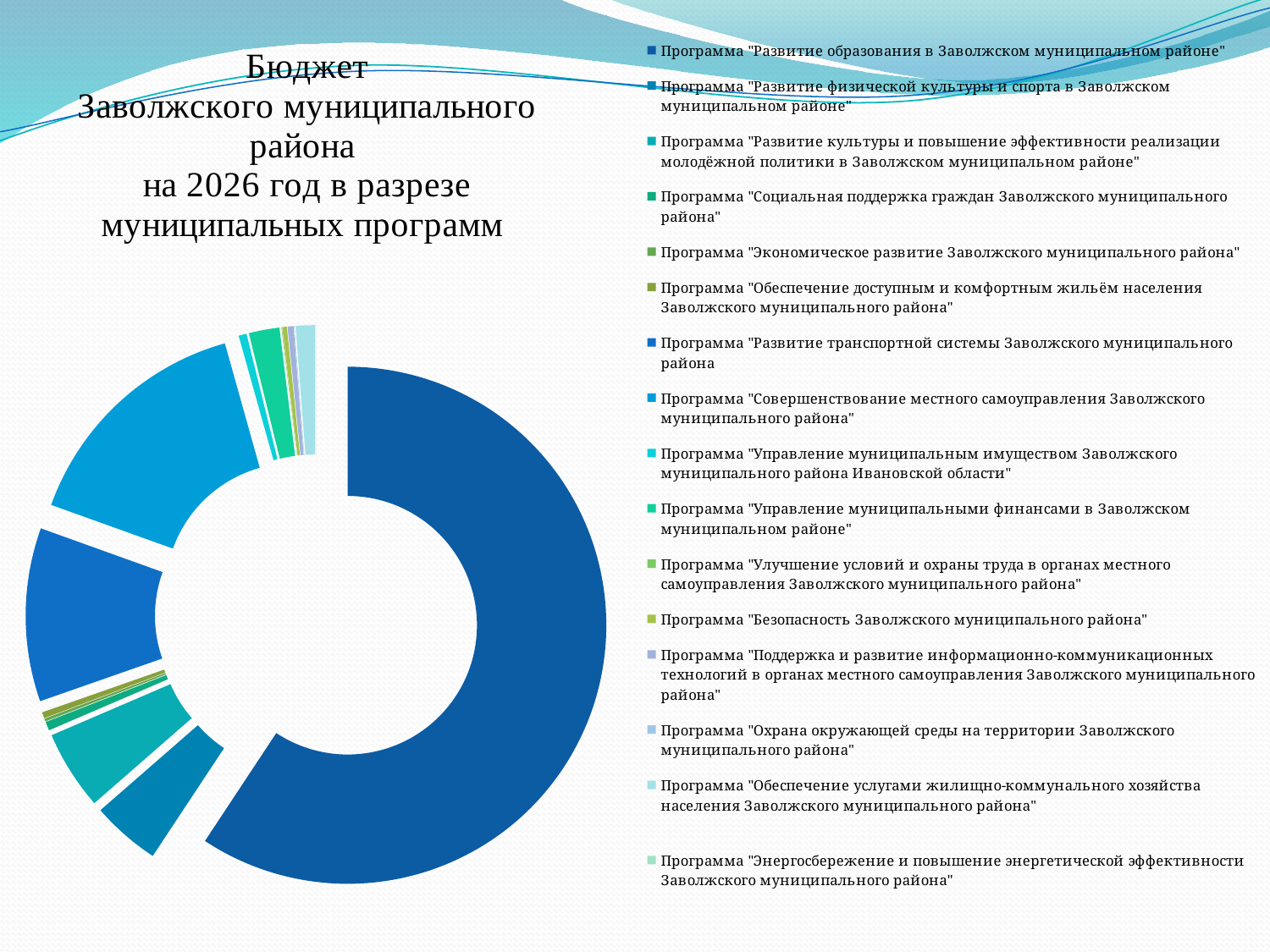
Which program has the largest slice in the chart? Программа "Развитие образования в Заволжском муниципальном районе" What kind of chart is shown on the slide? doughnut (pie) chart What is the title shown on the slide for the chart? Бюджет Заволжского муниципального района на 2026 год в разрезе муниципальных программ How many programs (categories) does the chart's legend list? 16 Which slice is larger: the one for Программа "Развитие образования в Заволжском муниципальном районе" or the one for Программа "Социальная поддержка граждан Заволжского муниципального района"? Программа "Развитие образования в Заволжском муниципальном районе" Which program is listed first in the chart's legend? Программа "Развитие образования в Заволжском муниципальном районе" Does the largest slice of the chart account for more or less than half of the whole? more What colour is the largest slice of the chart? dark blue